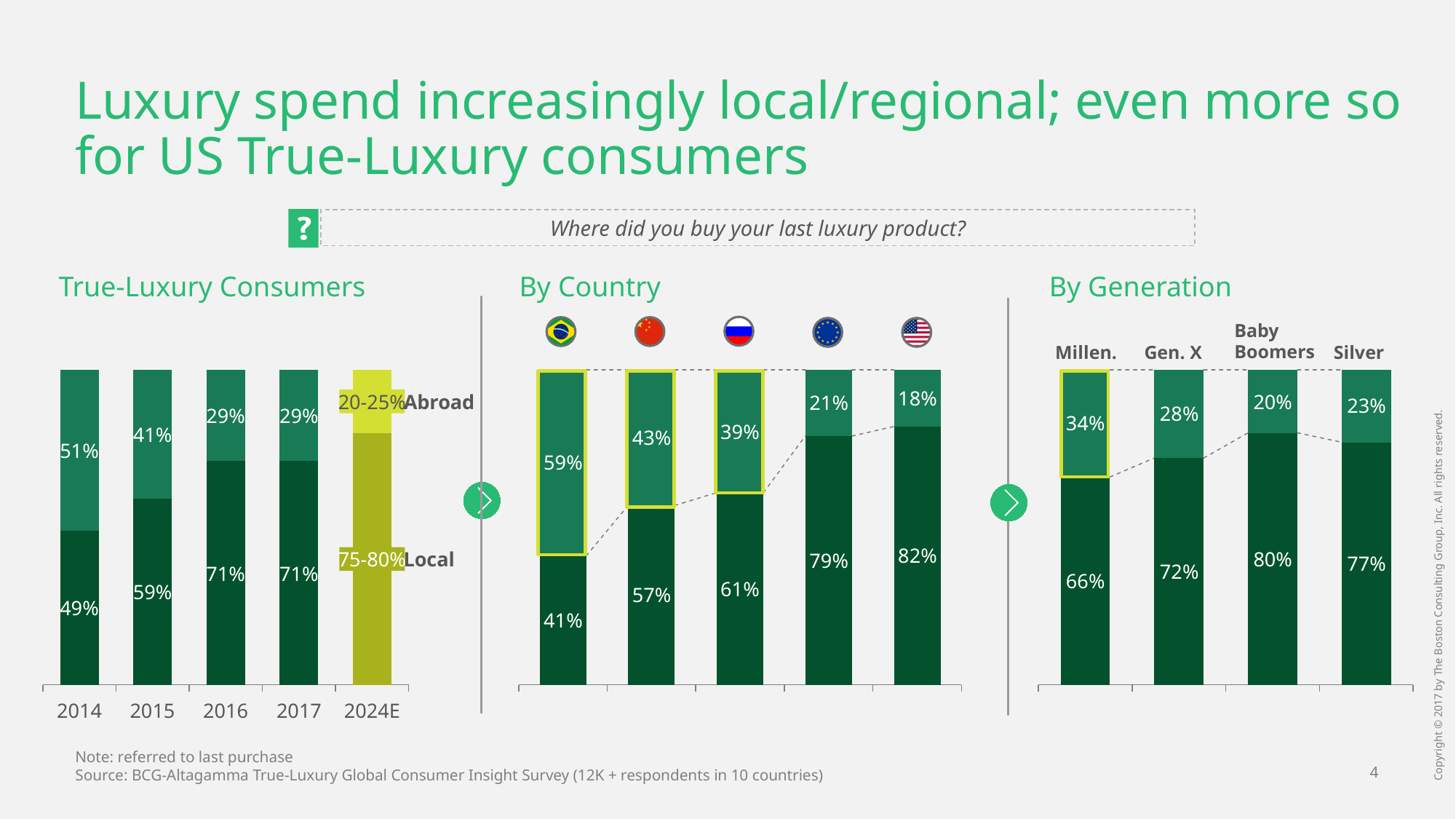
In the True-Luxury Consumers chart, what is the projected Local share for 2024E? 75-80% In the True-Luxury Consumers chart, what is the Local share in 2014? 49% In the By Country chart, how many countries are shown? 5 In the By Generation chart, is the Local share for Gen. X larger or smaller than for Silver? smaller In the By Generation chart, which generation has the highest Local share? Baby Boomers In the True-Luxury Consumers chart, what is the difference between the Local share in 2017 and in 2014? 22 percentage points In the True-Luxury Consumers chart, does the Local share rise or fall from 2014 to 2017? rise In the By Country chart, what is the Abroad share for the fifth (rightmost) country? 18% In the True-Luxury Consumers chart, which year has the highest Abroad share? 2014 In the By Generation chart, what is the Abroad share for Millennials? 34% In the True-Luxury Consumers chart, what is the Abroad share in 2015? 41% In the By Country chart, what is the Local share for the first (leftmost) country? 41%